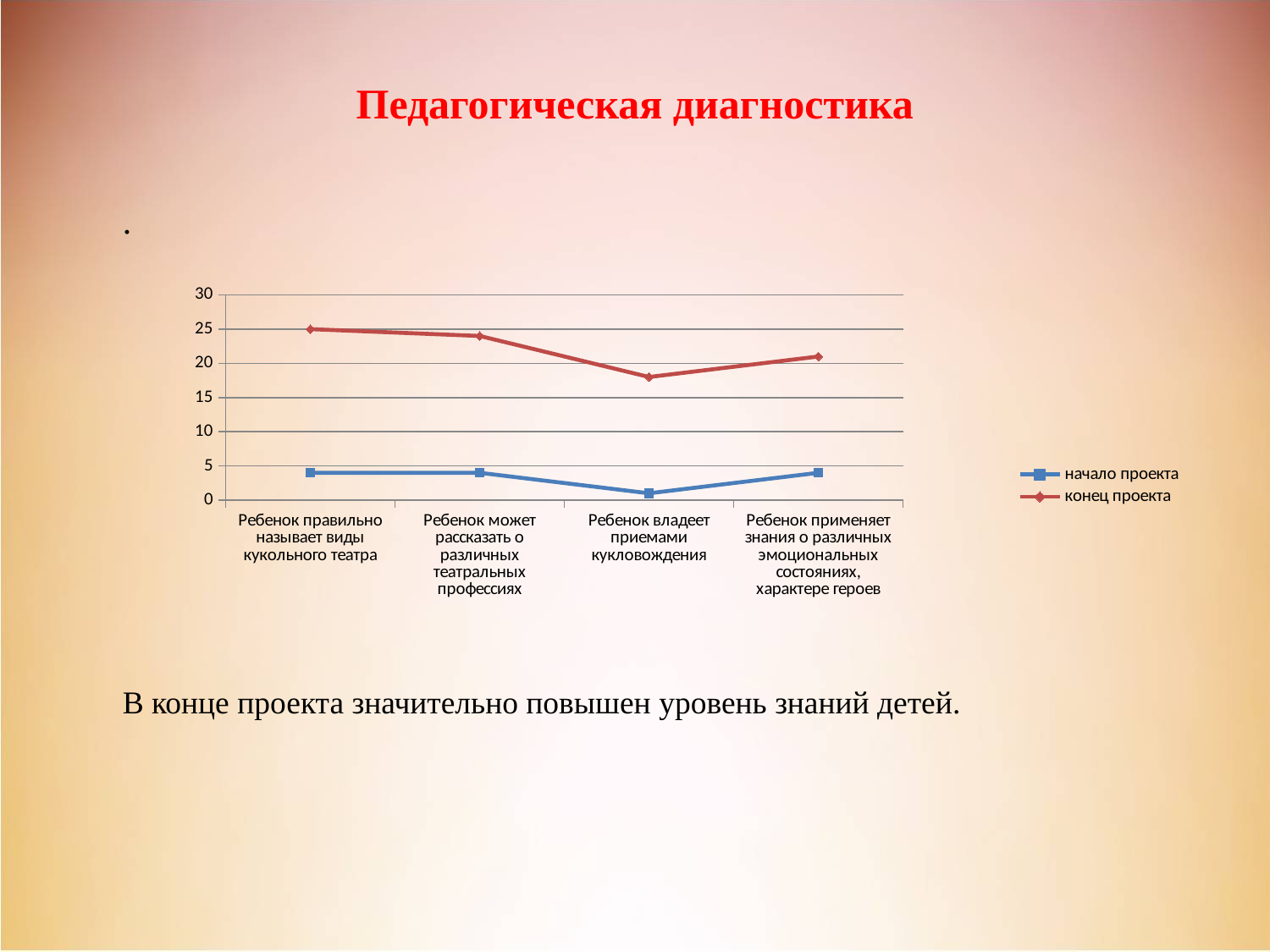
For "Ребенок может рассказать о различных театральных профессиях", which series has the larger value, "начало проекта" or "конец проекта"? конец проекта Is the value of "начало проекта" for "Ребенок владеет приемами кукловождения" greater or less than 5? less For which category is the "начало проекта" series lowest? Ребенок владеет приемами кукловождения How many series does the legend list? 2 What are the two entries in the chart legend? начало проекта, конец проекта How many categories are shown on the x axis? 4 What is the value of the "конец проекта" series for "Ребенок правильно называет виды кукольного театра"? 25 What kind of chart is shown on the slide? line chart Which series is drawn in red? конец проекта For which category is the "конец проекта" series lowest? Ребенок владеет приемами кукловождения Is the value of "конец проекта" for "Ребенок владеет приемами кукловождения" greater or less than 20? less